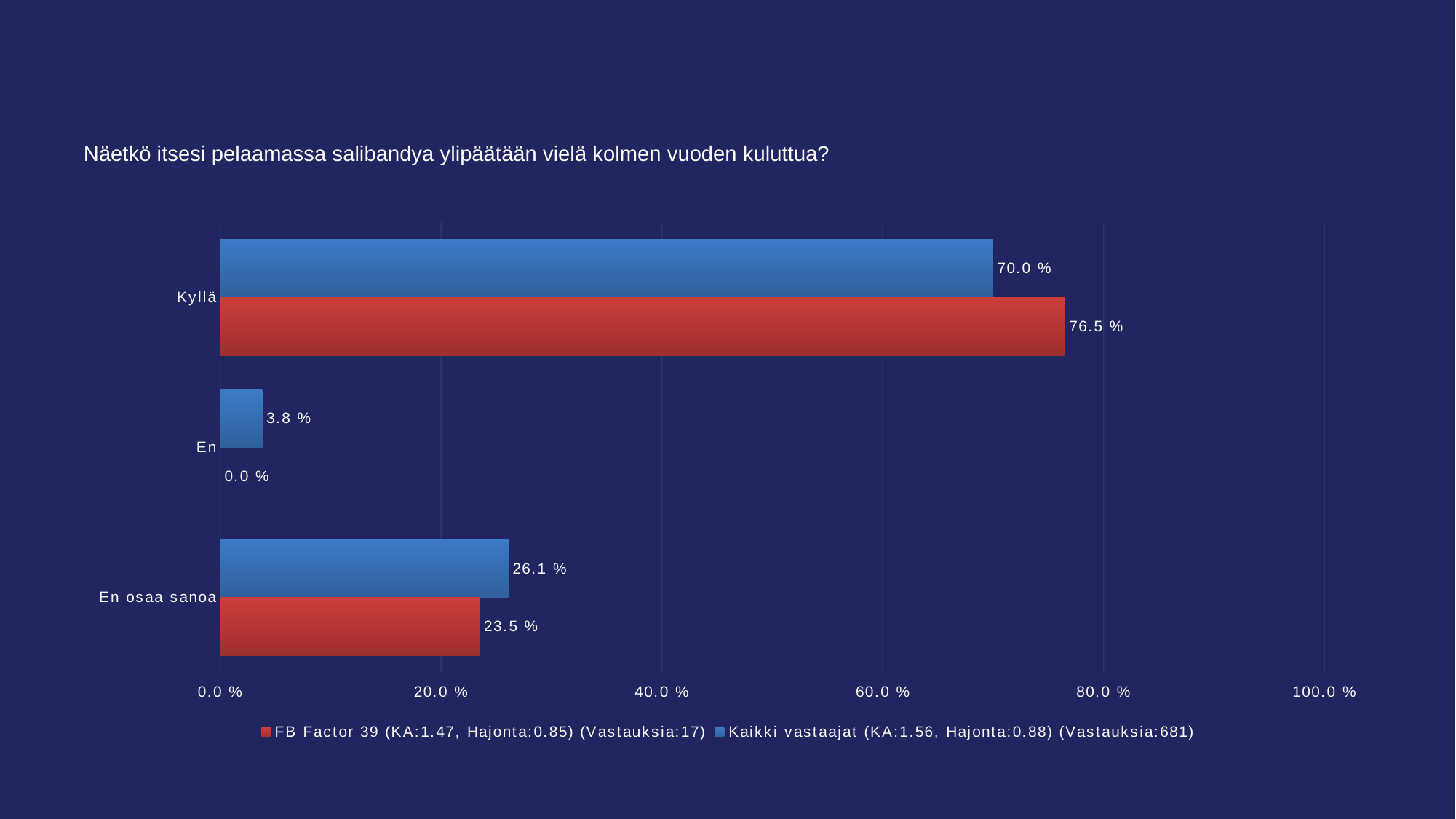
What is the difference between the FB Factor 39 and Kaikki vastaajat values for Kyllä? 6.5 % Which category has the lowest value in the FB Factor 39 series? En Which category has the highest value in the Kaikki vastaajat series? Kyllä What is the value for Kyllä in the Kaikki vastaajat series? 70.0 % What kind of chart is shown on the slide? Bar chart How many series does the legend list? 2 What is the value for En osaa sanoa in the FB Factor 39 series? 23.5 % How many categories are shown on the chart? 3 For En osaa sanoa, which series has the larger value, FB Factor 39 or Kaikki vastaajat? Kaikki vastaajat What is the value for En in the Kaikki vastaajat series? 3.8 % What is the value for En in the FB Factor 39 series? 0.0 % What is the value for Kyllä in the FB Factor 39 series? 76.5 %